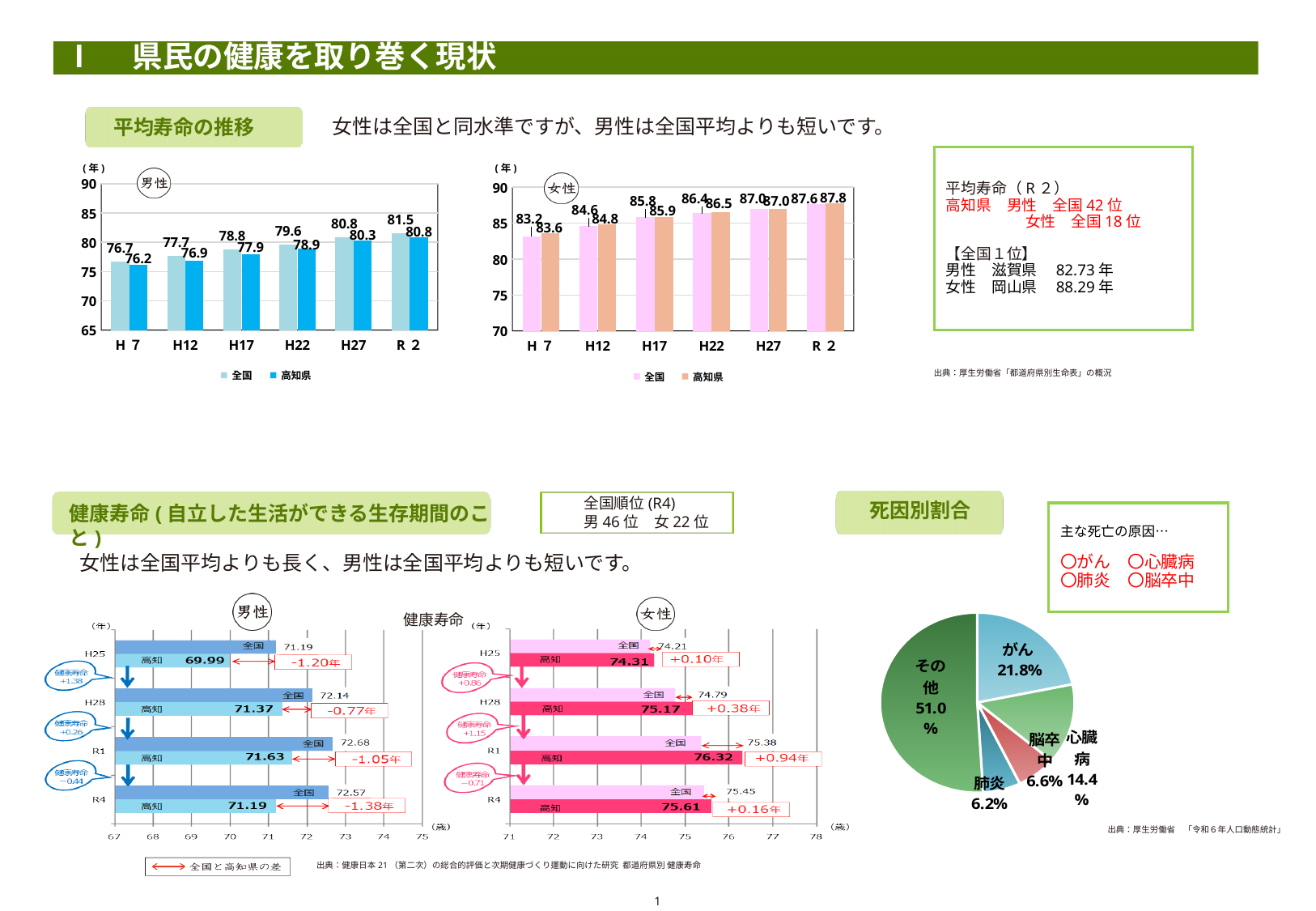
In the 女性 平均寿命 bar chart (top middle), which year has the lowest value for 全国? H7 In the 男性 平均寿命 bar chart (top left), what is the value for 高知県 in R2? 80.8 In the 女性 平均寿命 bar chart (top middle), do the 高知県 values rise or fall from H7 to R2? rise In the 男性 健康寿命 chart (bottom left), what is the value for 高知 in R4? 71.19 In the 女性 健康寿命 chart (bottom middle), what is the value for 高知 in R1? 76.32 In the 男性 平均寿命 bar chart (top left), what is the value for 全国 in H7? 76.7 In the 女性 平均寿命 bar chart (top middle), what is the value for 高知県 in R2? 87.8 In the 死因別割合 pie chart, what share does がん have? 21.8% What kind of chart is the 死因別割合 chart on the bottom right? pie chart How many series does the legend of the 男性 平均寿命 bar chart (top left) list? 2 In the 男性 平均寿命 bar chart (top left), what is the difference between 全国 and 高知県 in R2? 0.7 In the 男性 健康寿命 chart (bottom left), what is the difference between 全国 and 高知 shown for H25? -1.20年